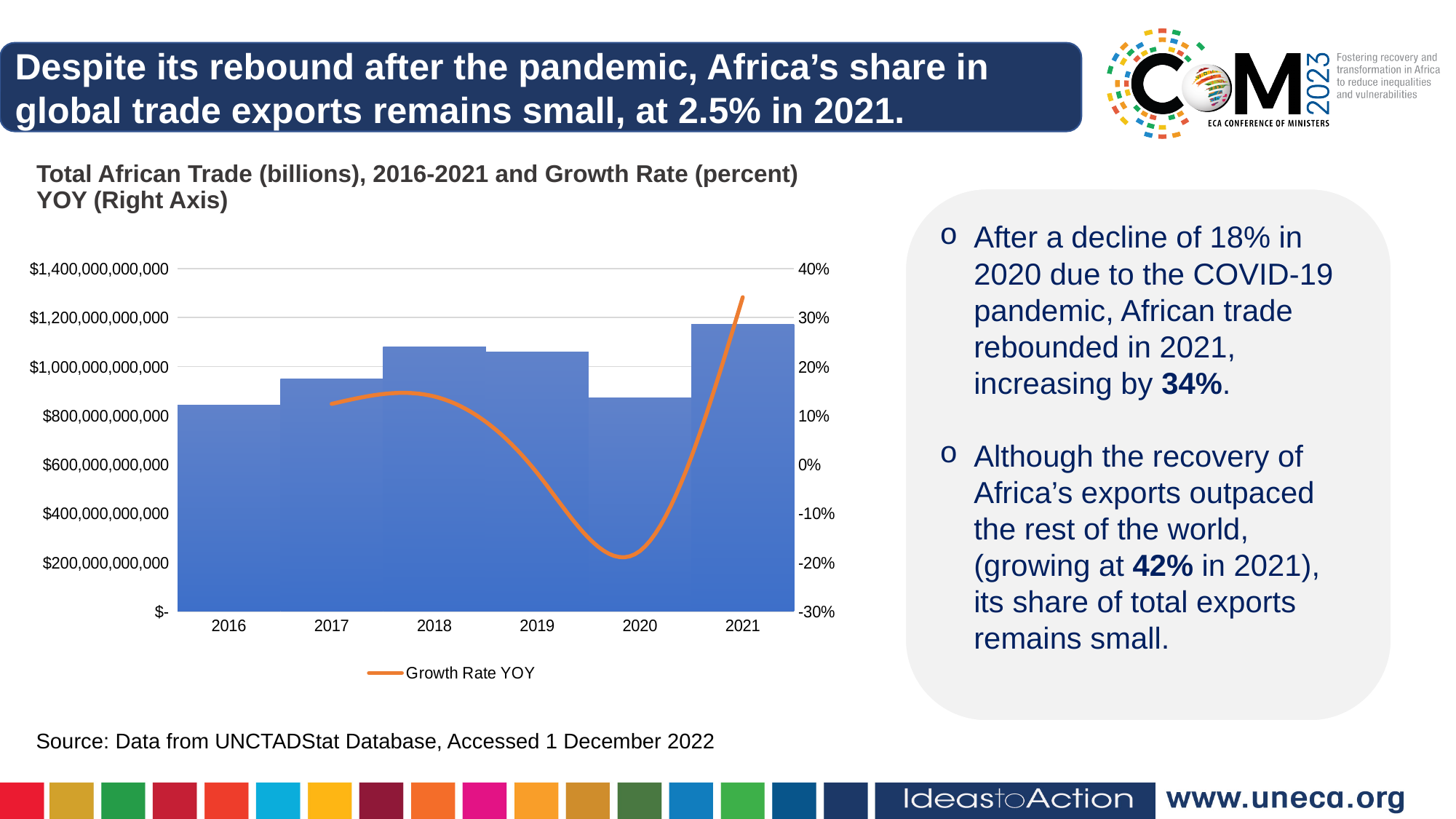
Is the Growth Rate YOY value for 2020 greater or less than -10%? less In which year does the Growth Rate YOY line reach its highest point? 2021 Is the total African trade bar larger in 2021 or in 2017? 2021 Is the total African trade bar for 2016 greater or less than $1,000,000,000,000? less How many series does the chart legend list? 1 Which year has the highest total African trade bar? 2021 How many years are shown on the x axis of the chart? 6 Is the Growth Rate YOY value for 2021 greater or less than 30%? greater What kind of chart is shown on the slide? Combined bar and line chart Which year has the lowest total African trade bar? 2016 In which year does the Growth Rate YOY line reach its lowest point? 2020